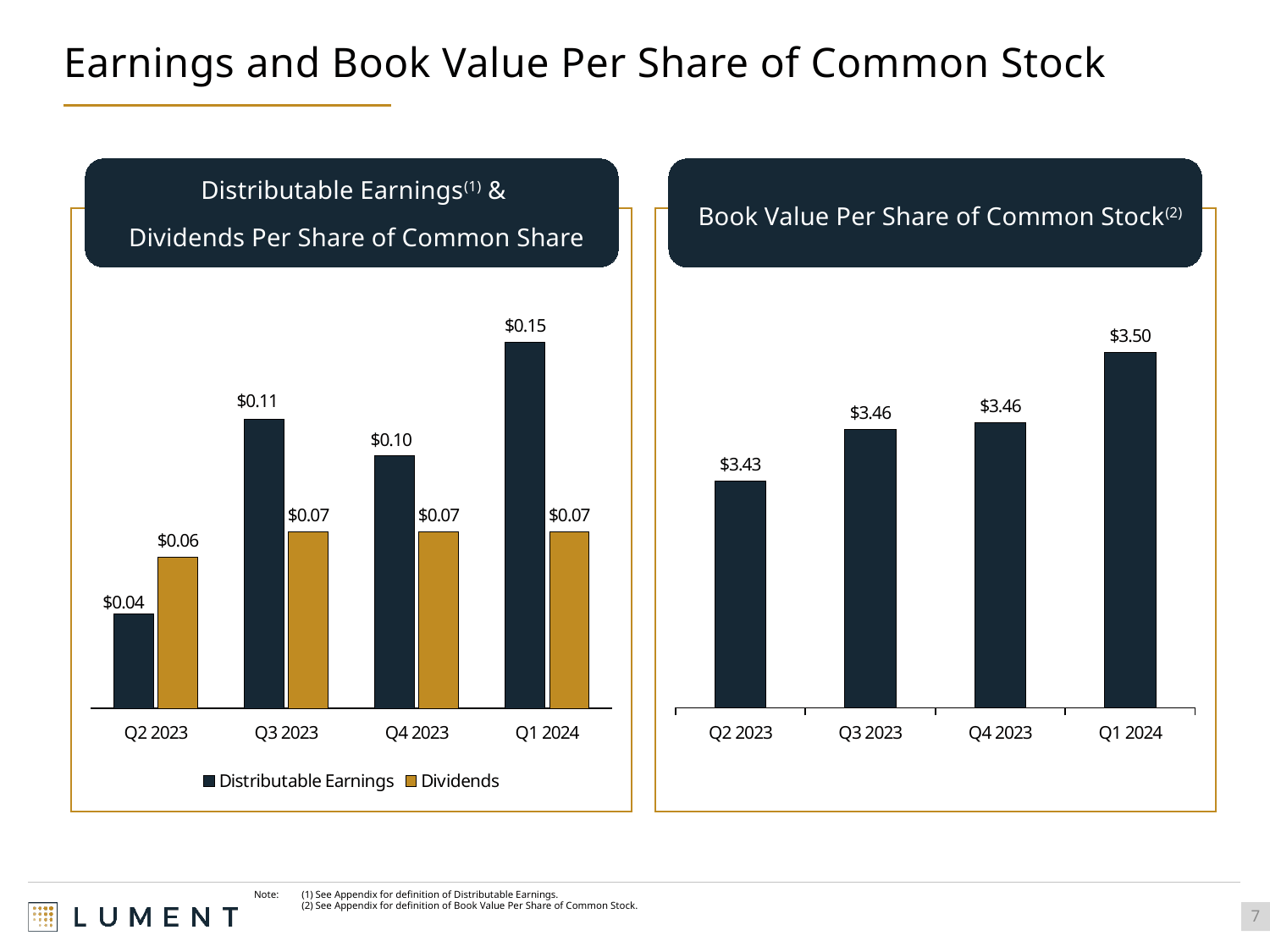
In the Book Value Per Share of Common Stock chart, what is the difference between Q1 2024 and Q2 2023? $0.07 How many series does the legend of the Distributable Earnings & Dividends chart list? 2 How many quarters are shown on the x axis of the Book Value Per Share of Common Stock chart? 4 In the Distributable Earnings & Dividends chart, which quarter has the lowest Distributable Earnings? Q2 2023 In the Distributable Earnings & Dividends chart, what is the difference between Distributable Earnings and Dividends in Q1 2024? $0.08 In the Book Value Per Share of Common Stock chart, what is the value for Q2 2023? $3.43 In the Book Value Per Share of Common Stock chart, which quarter has the highest value? Q1 2024 In the Distributable Earnings & Dividends chart, which quarter has the highest Distributable Earnings? Q1 2024 What type of chart is the Book Value Per Share of Common Stock chart? Bar chart In the Distributable Earnings & Dividends chart, which is larger in Q2 2023: Distributable Earnings or Dividends? Dividends In the Distributable Earnings & Dividends chart, what is the Dividends value for Q2 2023? $0.06 In the Distributable Earnings & Dividends chart, what is the Distributable Earnings value for Q1 2024? $0.15